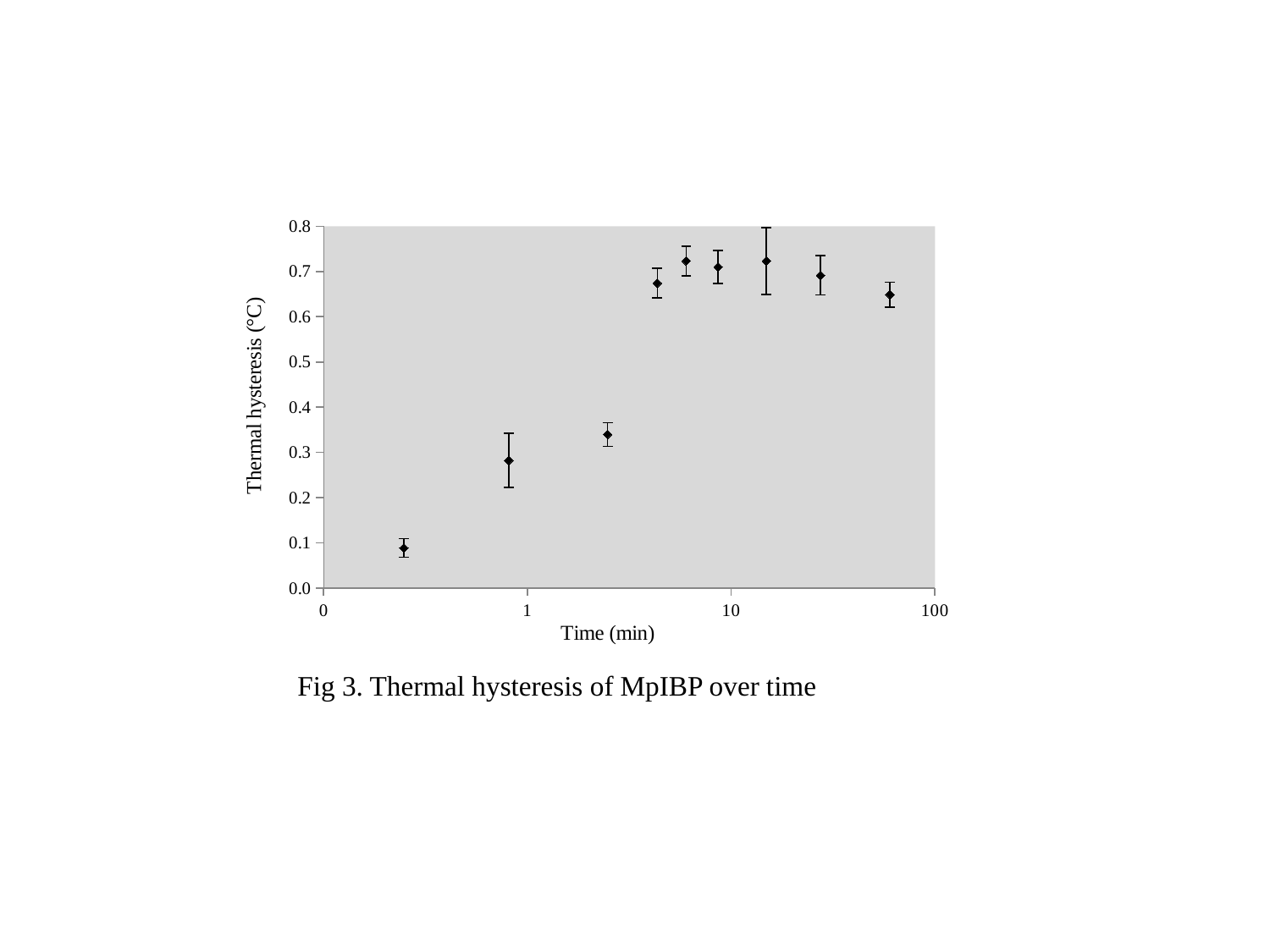
Does thermal hysteresis generally rise or fall over the first few minutes along the x axis? rise Which data point has the lowest thermal hysteresis value? the leftmost point (earliest time) Is the value of the fourth data point from the left greater or less than 0.6? greater What is the title of the figure shown on the slide? Fig 3. Thermal hysteresis of MpIBP over time What kind of chart is shown on the slide? scatter plot What is the label of the y axis? Thermal hysteresis (°C) Is the value of the rightmost data point greater or less than 0.6? greater Is the value of the leftmost data point greater or less than 0.2? less Which is larger, the thermal hysteresis of the leftmost data point or the rightmost data point? the rightmost data point How many data points are plotted in the chart? 9